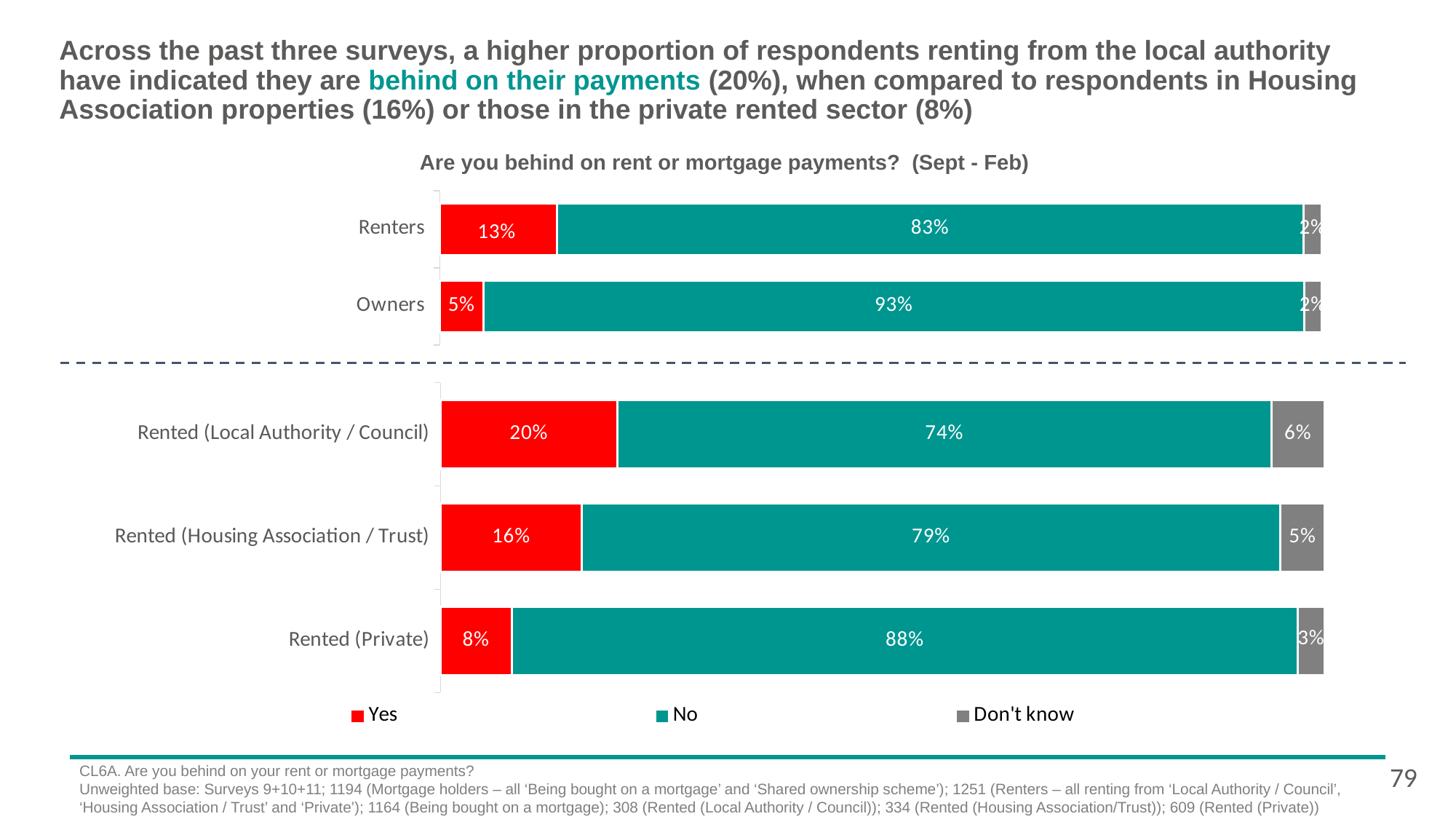
What percentage of Renters answered 'Yes' to being behind on rent or mortgage payments? 13% Which category has the highest 'Yes' value? Rented (Local Authority / Council) How many categories are shown on the chart? 5 How many series does the legend list? 3 What is the 'No' value for Owners? 93% What is the difference between the 'Yes' values for Rented (Local Authority / Council) and Rented (Private)? 12% What kind of chart is shown on the slide? Stacked bar chart Which is larger: the 'No' value for Rented (Private) or the 'No' value for Renters? Rented (Private) What is the total of the stacked bar for Owners? 100% Which category has the lowest 'Yes' value? Owners What is the 'Don't know' value for Rented (Local Authority / Council)? 6% What is the 'No' value for Rented (Housing Association / Trust)? 79%